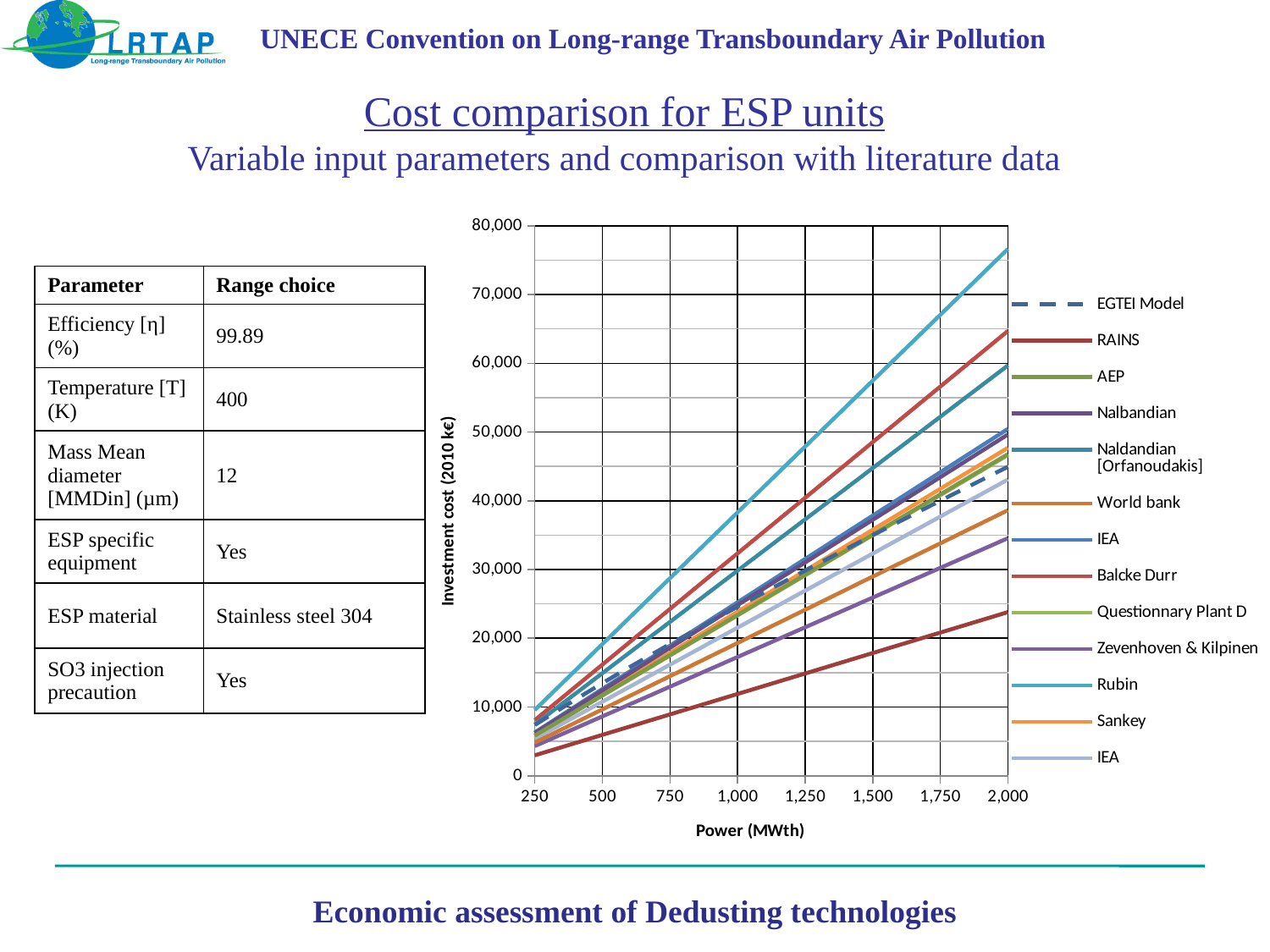
What kind of chart is shown on the slide? line chart Is the investment cost for Rubin at 1,000 MWth greater or less than 30,000? greater Which series has the lowest investment cost at 2,000 MWth? RAINS What is the label of the x axis of the chart? Power (MWth) How many series does the chart legend list? 13 Which series has the highest investment cost at 2,000 MWth? Rubin Do the investment cost lines rise or fall as power increases along the x axis? rise How many tick values are shown on the x axis of the chart? 8 Is the investment cost for Rubin at 2,000 MWth greater or less than 70,000? greater Which series in the legend is drawn with a dashed line? EGTEI Model Which of Rubin or Zevenhoven & Kilpinen has the higher investment cost at 2,000 MWth? Rubin Is the investment cost for RAINS at 2,000 MWth greater or less than 30,000? less